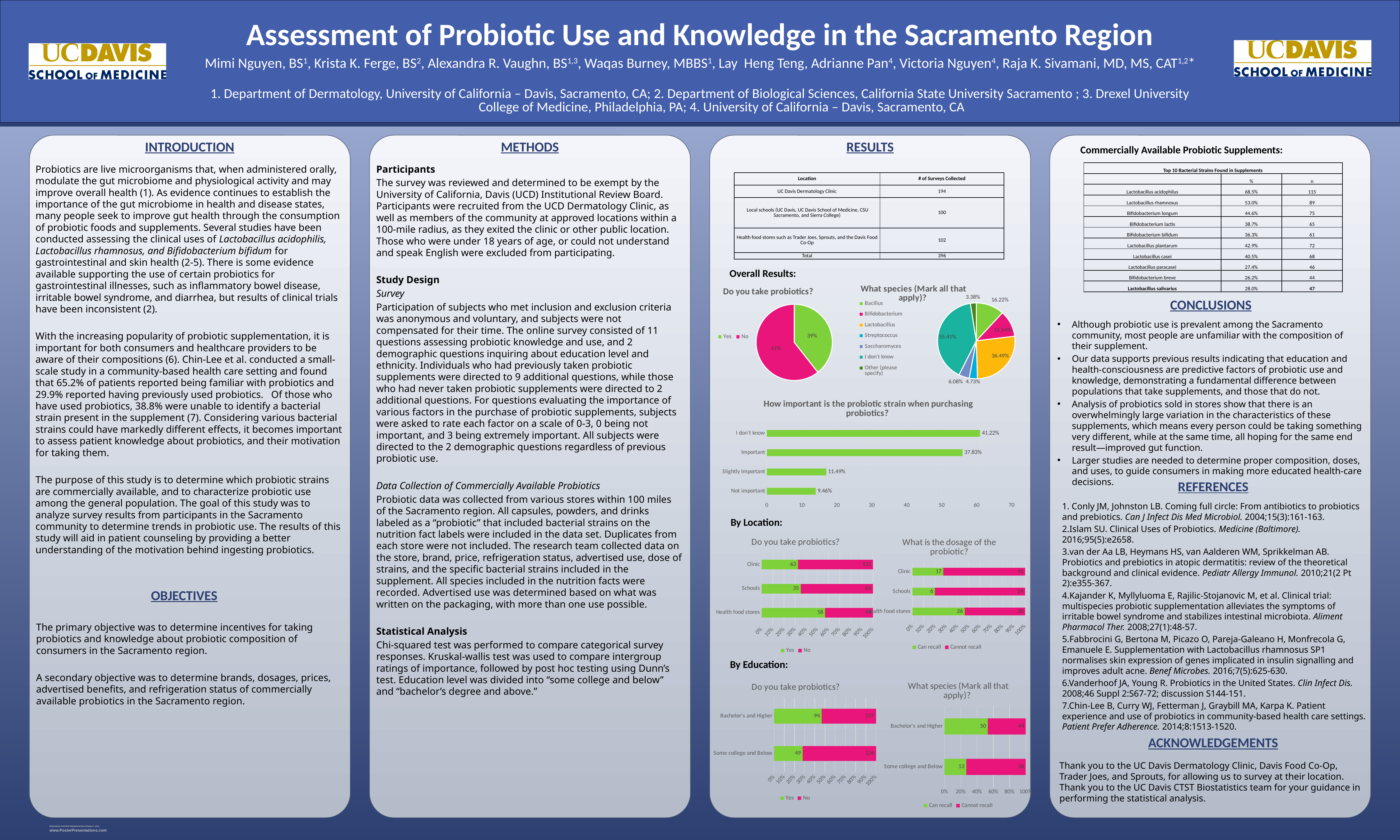
In the By Location 'What is the dosage of the probiotic?' chart, how many Schools respondents could recall the dosage? 6 In the overall 'What species (Mark all that apply)?' pie chart, what percentage is shown for Lactobacillus? 36.49% In the By Location 'Do you take probiotics?' chart, what is the total number of Health food stores respondents (Yes plus No)? 102 What kind of chart is 'How important is the probiotic strain when purchasing probiotics?' Bar chart In the overall 'What species (Mark all that apply)?' pie chart, which category has the largest slice? I don't know In the 'How important is the probiotic strain when purchasing probiotics?' bar chart, what is the value for 'Important'? 37.83% In the overall 'Do you take probiotics?' pie chart, what percentage of respondents answered No? 61% In the overall 'Do you take probiotics?' pie chart, what percentage of respondents answered Yes? 39% In the 'How important is the probiotic strain when purchasing probiotics?' bar chart, what is the difference between 'I don't know' and 'Important'? 3.39% In the By Location 'Do you take probiotics?' chart, how many Clinic respondents answered No? 131 In the By Education 'What species (Mark all that apply)?' chart, which is larger for 'Some college and Below': Can recall or Cannot recall? Cannot recall In the 'How important is the probiotic strain when purchasing probiotics?' bar chart, which category has the lowest value? Not important